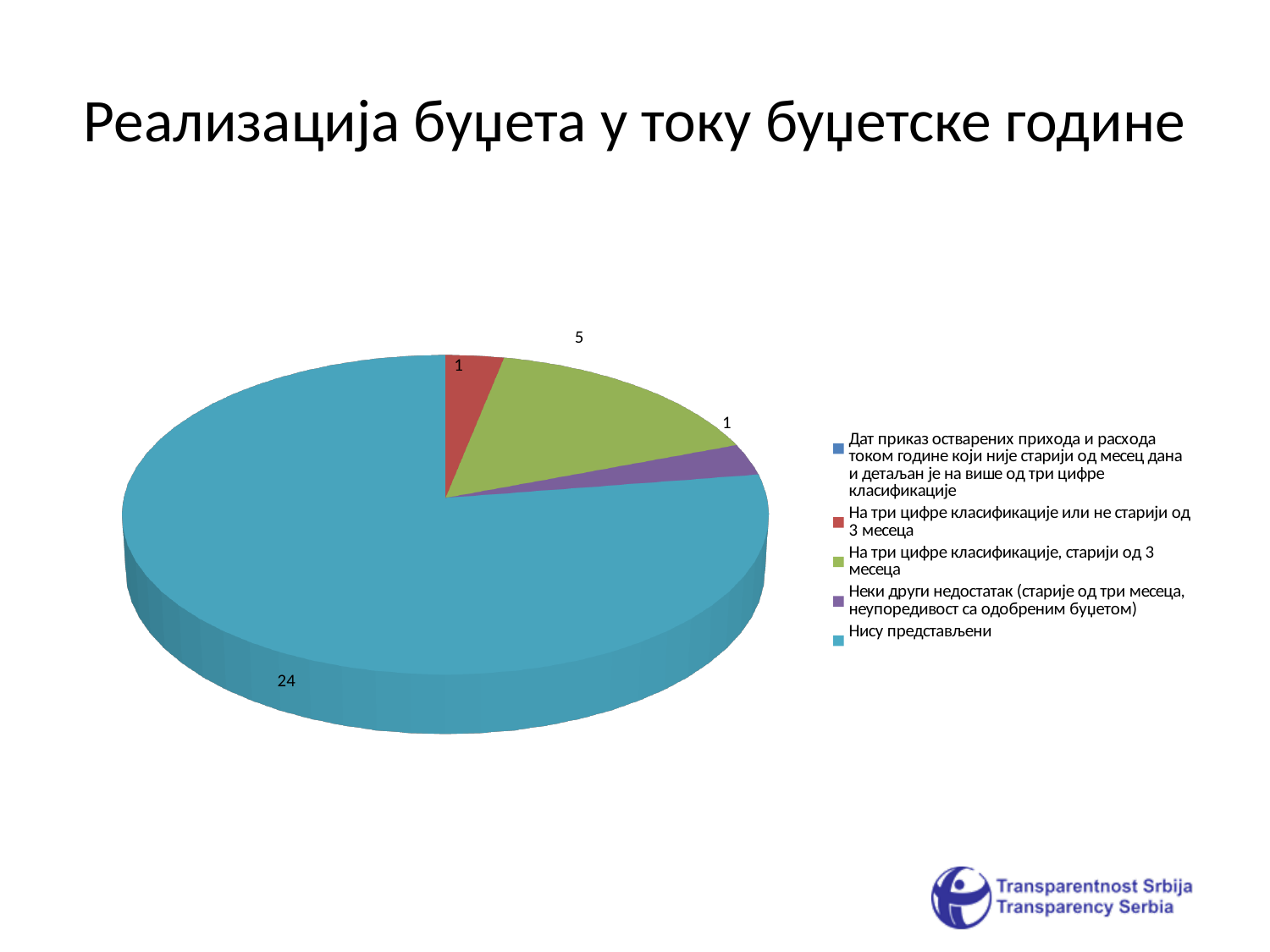
What is the difference between the value for 'Нису представљени' and the value for 'На три цифре класификације, старији од 3 месеца'? 19 What kind of chart is shown on the slide? pie chart What is the title of the slide? Реализација буџета у току буџетске године What is the value for the slice 'Нису представљени'? 24 What is the value for the slice 'На три цифре класификације или не старији од 3 месеца'? 1 Which is larger: the value for 'На три цифре класификације, старији од 3 месеца' or the value for 'На три цифре класификације или не старији од 3 месеца'? На три цифре класификације, старији од 3 месеца What is the value for the slice 'Неки други недостатак (старије од три месеца, неупоредивост са одобреним буџетом)'? 1 What is the value for the slice 'На три цифре класификације, старији од 3 месеца'? 5 Which category has the largest slice of the pie? Нису представљени How many data labels are printed on the pie? 4 What is the difference between the value for 'На три цифре класификације, старији од 3 месеца' and the value for 'На три цифре класификације или не старији од 3 месеца'? 4 How many entries does the legend list? 5